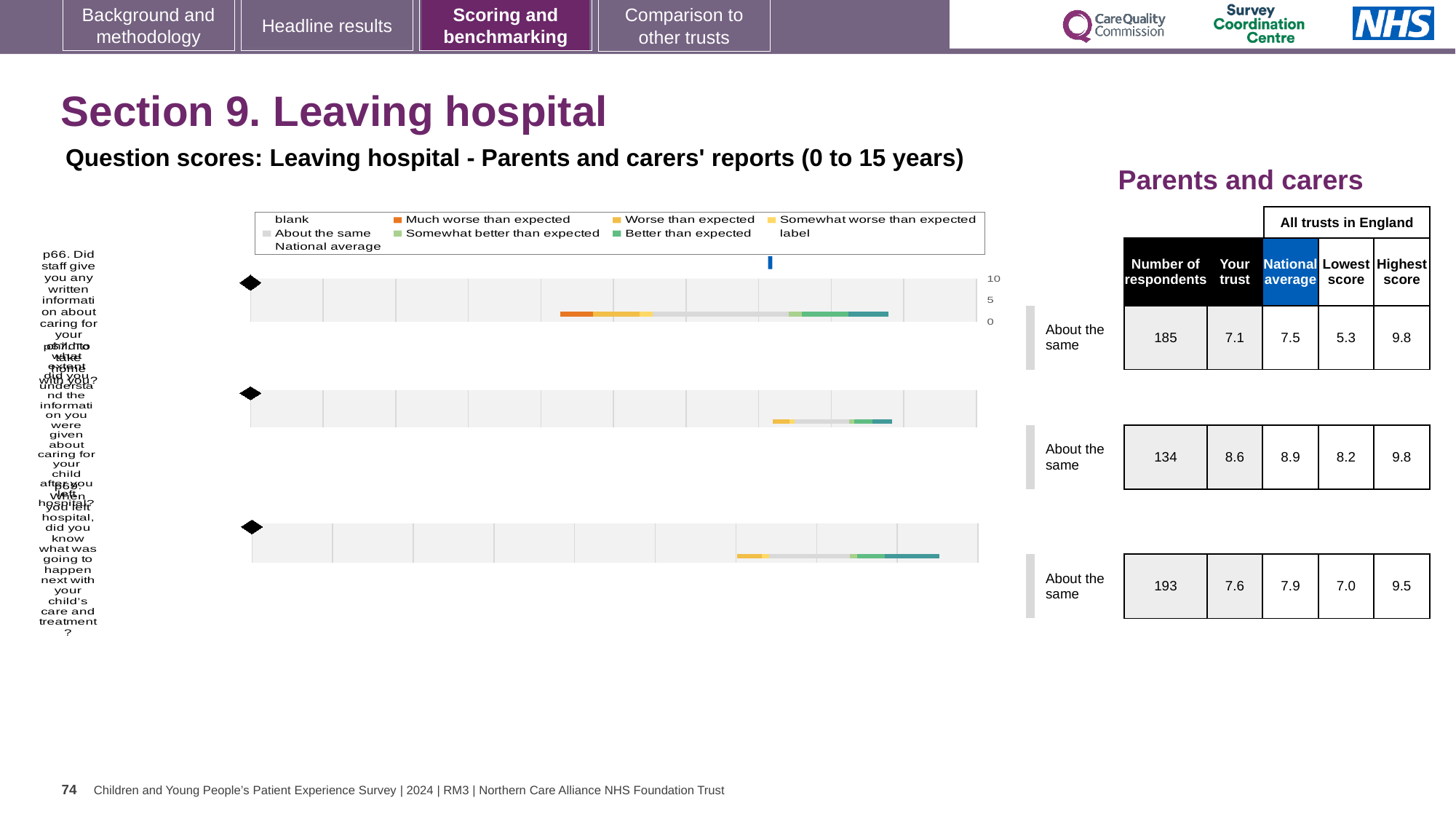
How many question score charts are shown on the slide? 3 For the top chart, what is the national average score shown in the table? 7.5 For the bottom chart, what is the number of respondents shown in the table? 193 How many entries does the legend above the charts list? 9 For the bottom chart, what is the highest score among all trusts in England? 9.5 Which of the three charts has the lowest number of respondents? the middle chart For the middle chart, what is the 'Your trust' score shown in the table? 8.6 Which chart has the higher 'Your trust' score, the top chart or the middle chart? the middle chart What benchmark category is shown beside each of the three charts? About the same What kind of chart is used to show the question scores on this slide? bar chart For the top chart, what is the difference between the national average and the 'Your trust' score? 0.4 For the top chart, what is the 'Your trust' score shown in the table? 7.1